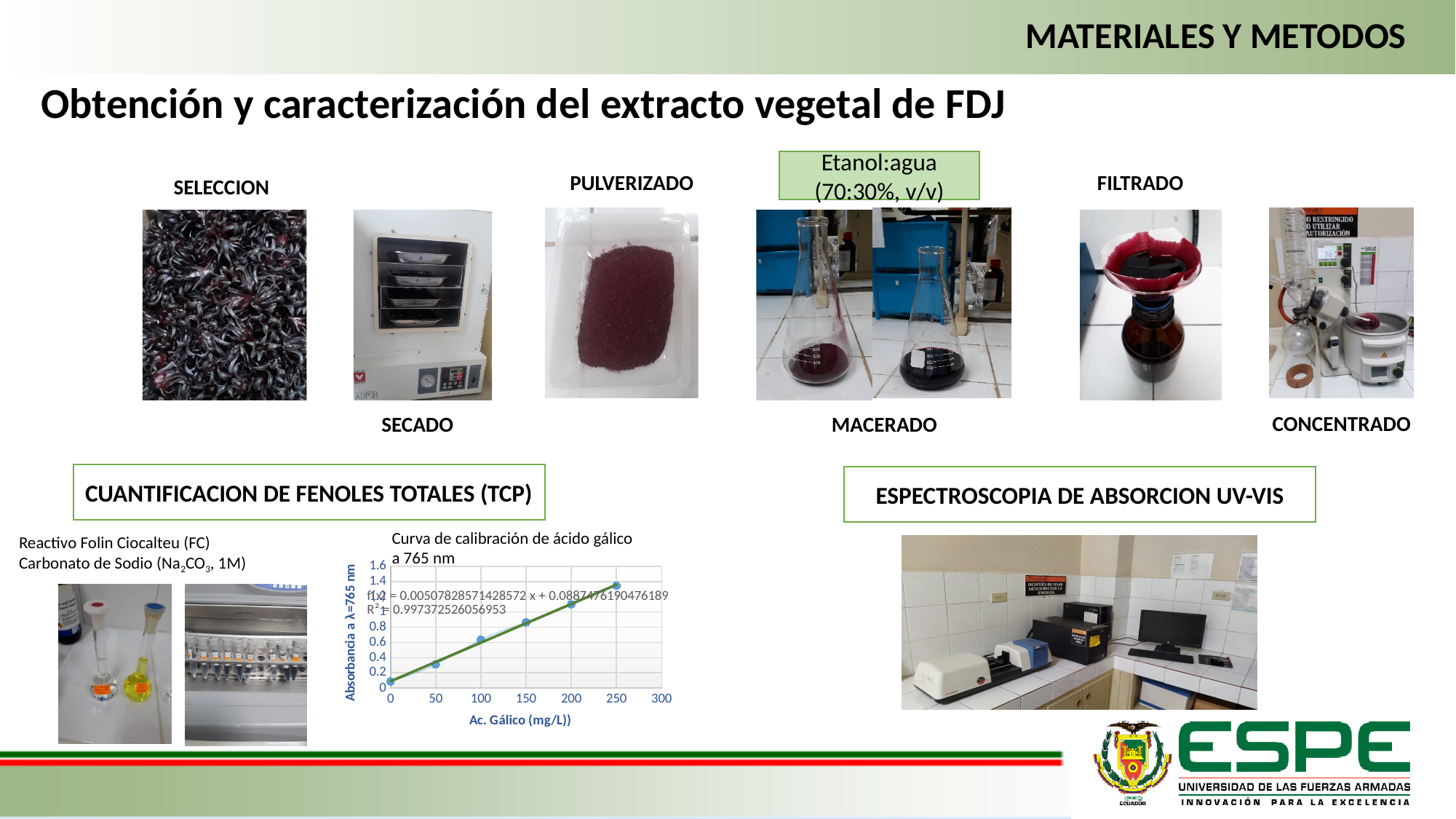
In the calibration curve chart, is the absorbance at 50 mg/L greater or less than 0.4? less In the calibration curve chart, does absorbance rise or fall as the gallic acid concentration increases? rise How many data points are plotted in the calibration curve chart? 6 In the calibration curve chart, which gallic acid concentration has the highest absorbance? 250 In the calibration curve chart, is the absorbance at 100 mg/L greater or less than 0.4? greater In the calibration curve chart, is the absorbance at 250 mg/L greater or less than 1.2? greater What kind of chart is the 'Curva de calibración de ácido gálico a 765 nm'? scatter chart with a trendline What is the label of the x axis of the calibration curve chart? Ac. Gálico (mg/L)) What R² value is shown on the calibration curve chart? 0.997372526056953 In the calibration curve chart, which has the higher absorbance: 200 mg/L or 100 mg/L? 200 mg/L In the calibration curve chart, which gallic acid concentration has the lowest absorbance? 0